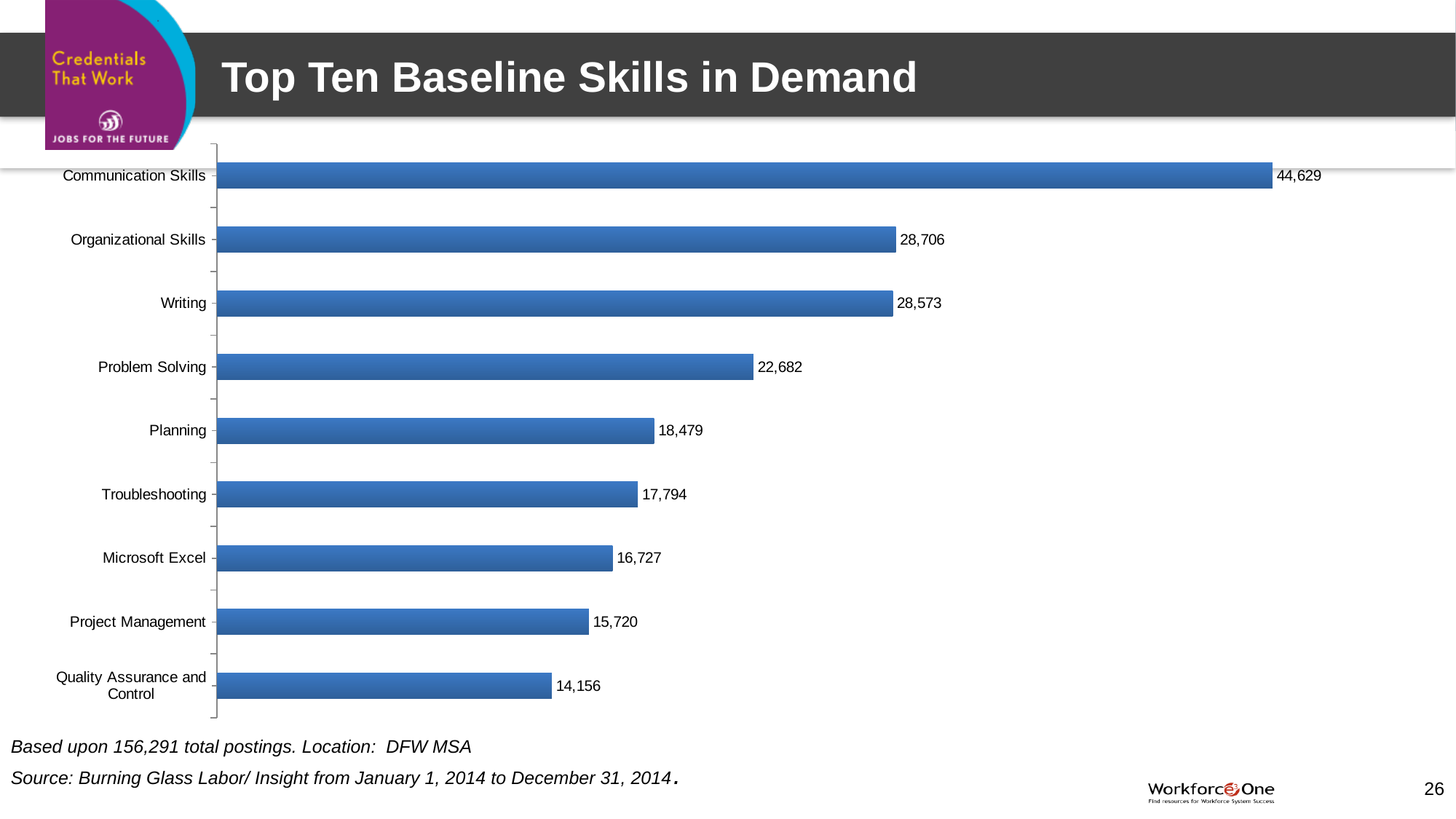
What is the value for Quality Assurance and Control? 14,156 What is the value for Problem Solving? 22,682 What is the difference between the values for Communication Skills and Organizational Skills? 15,923 What kind of chart is shown on the slide? Bar chart What is the value for Microsoft Excel? 16,727 How many skills are shown in the chart? 9 What is the title of the slide? Top Ten Baseline Skills in Demand Which is larger, the value for Troubleshooting or the value for Project Management? Troubleshooting What is the value for Communication Skills? 44,629 Which skill has the lowest value? Quality Assurance and Control What is the difference between the values for Problem Solving and Planning? 4,203 Which skill has the highest value? Communication Skills